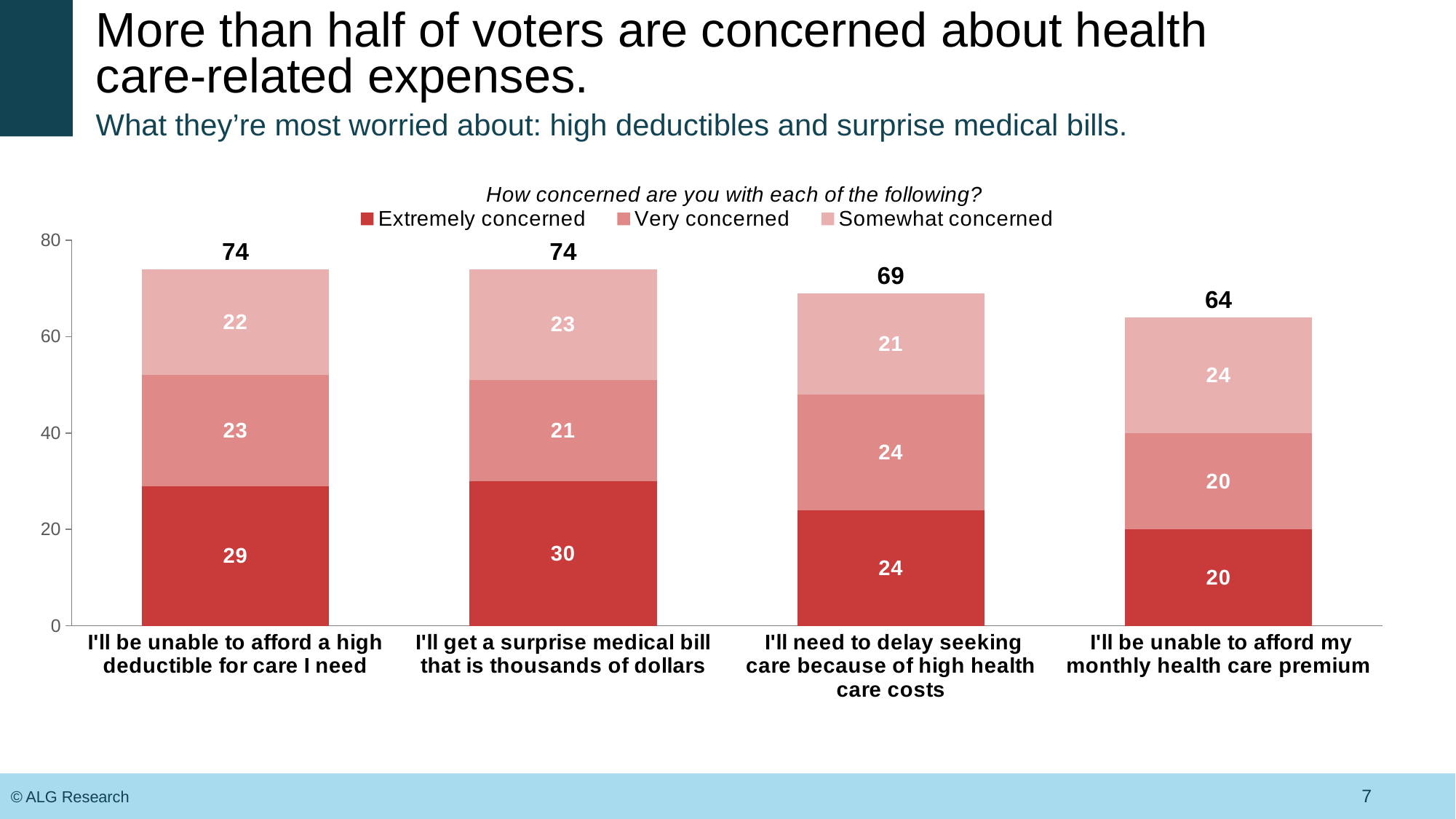
What is the 'Somewhat concerned' value for 'I'll be unable to afford my monthly health care premium'? 24 What is the difference between the stacked bar totals for 'I'll be unable to afford a high deductible for care I need' and 'I'll be unable to afford my monthly health care premium'? 10 What is the 'Extremely concerned' value for 'I'll get a surprise medical bill that is thousands of dollars'? 30 Which is larger: the 'Extremely concerned' value for 'I'll be unable to afford a high deductible for care I need' or for 'I'll be unable to afford my monthly health care premium'? I'll be unable to afford a high deductible for care I need What is the 'Very concerned' value for 'I'll need to delay seeking care because of high health care costs'? 24 Which category has the highest 'Extremely concerned' value? I'll get a surprise medical bill that is thousands of dollars Which category has the lowest stacked bar total? I'll be unable to afford my monthly health care premium What question is shown as the chart's title? How concerned are you with each of the following? How many series does the legend list? 3 How many categories are shown on the x axis? 4 What kind of chart is shown on the slide? Stacked bar chart What is the total of the stacked bar for 'I'll need to delay seeking care because of high health care costs'? 69